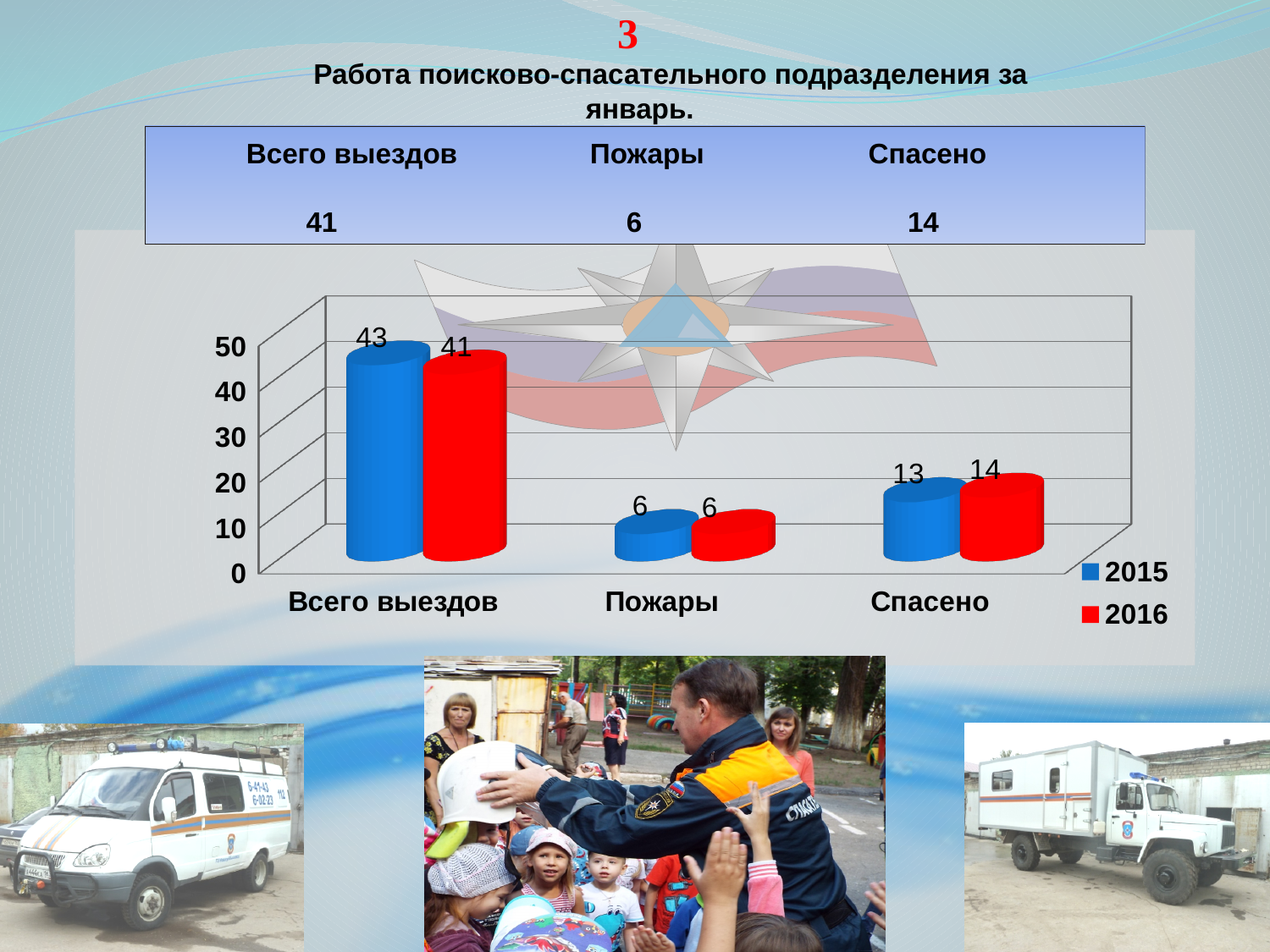
What is the value for 2016 in the "Спасено" category? 14 Which colour represents the 2016 series in the chart? Red What is the value for 2015 in the "Пожары" category? 6 What kind of chart is shown on the slide? Bar chart How many series does the chart legend list? 2 In the "Спасено" category, which series has the larger value, 2015 or 2016? 2016 What is the value for 2015 in the "Всего выездов" category? 43 What is the value for 2016 in the "Всего выездов" category? 41 Which category has the highest value for the 2015 series? Всего выездов What is the difference between the 2015 and 2016 values in the "Всего выездов" category? 2 Which category has the lowest value for the 2016 series? Пожары How many categories are shown on the x axis of the chart? 3